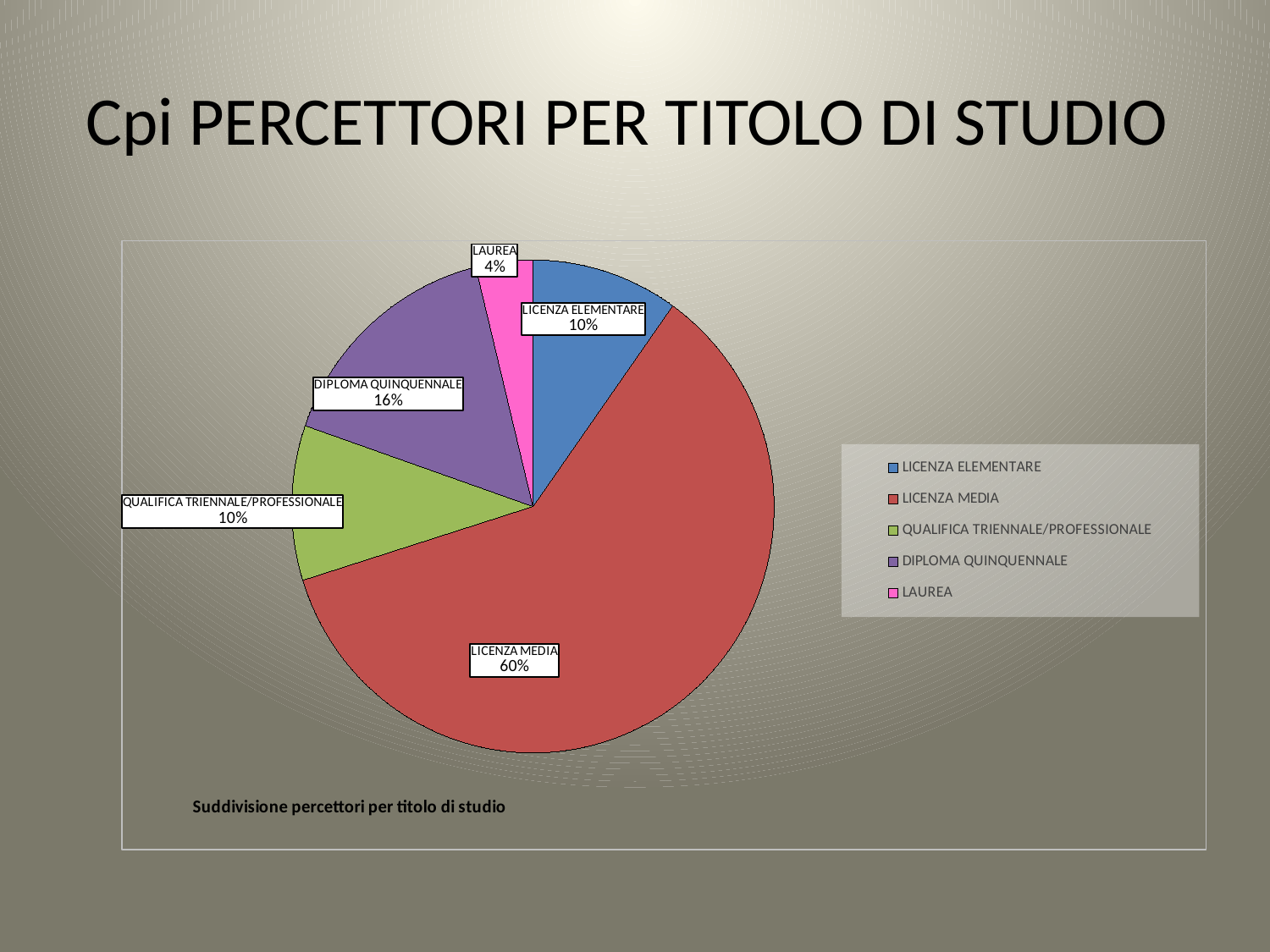
Which category has the largest slice of the pie? LICENZA MEDIA What kind of chart is shown on the slide? pie chart What is the value shown for LICENZA ELEMENTARE? 10% What is the value shown for DIPLOMA QUINQUENNALE? 16% What share of the pie does LICENZA MEDIA represent? 60% How many categories does the pie chart have? 5 What is the caption text shown below the pie chart? Suddivisione percettori per titolo di studio What is the difference in percentage points between LICENZA MEDIA and DIPLOMA QUINQUENNALE? 44 What is the value shown for LAUREA? 4% Which is larger, the slice for DIPLOMA QUINQUENNALE or the slice for LICENZA ELEMENTARE? DIPLOMA QUINQUENNALE Which category has the smallest slice of the pie? LAUREA What is the value shown for QUALIFICA TRIENNALE/PROFESSIONALE? 10%